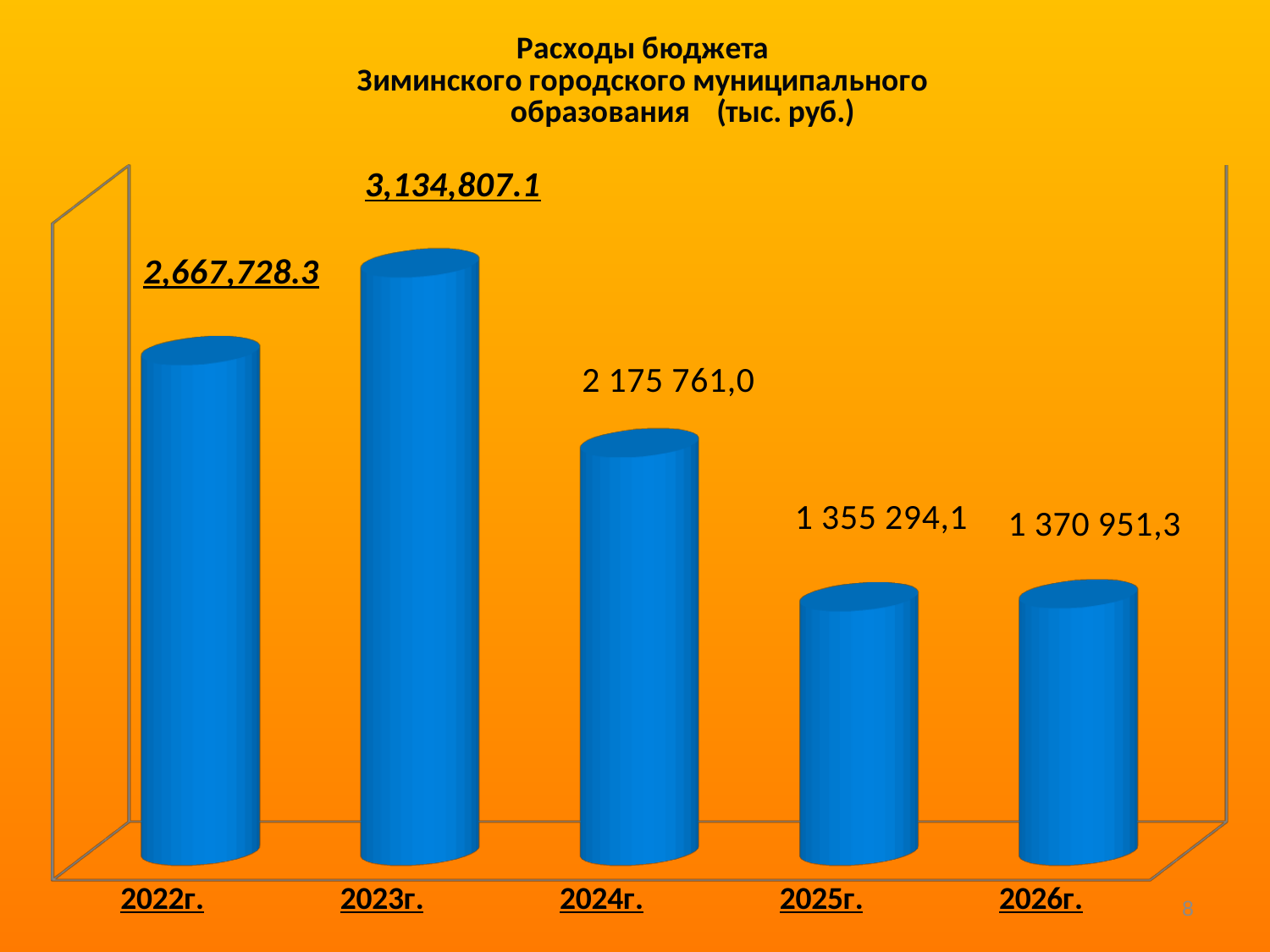
Which year has the lowest value? 2025г. What is the value for 2024г.? 2 175 761,0 Which is larger, the value for 2025г. or the value for 2026г.? 2026г. Do the values rise or fall from 2023г. to 2025г.? fall How many years are shown on the chart? 5 What kind of chart is this? bar chart Which year has the highest value? 2023г. What is the value for 2022г.? 2,667,728.3 What is the value for 2026г.? 1 370 951,3 What is the value for 2023г.? 3,134,807.1 What is the value for 2025г.? 1 355 294,1 What is the difference between the values for 2023г. and 2022г.? 467,078.8